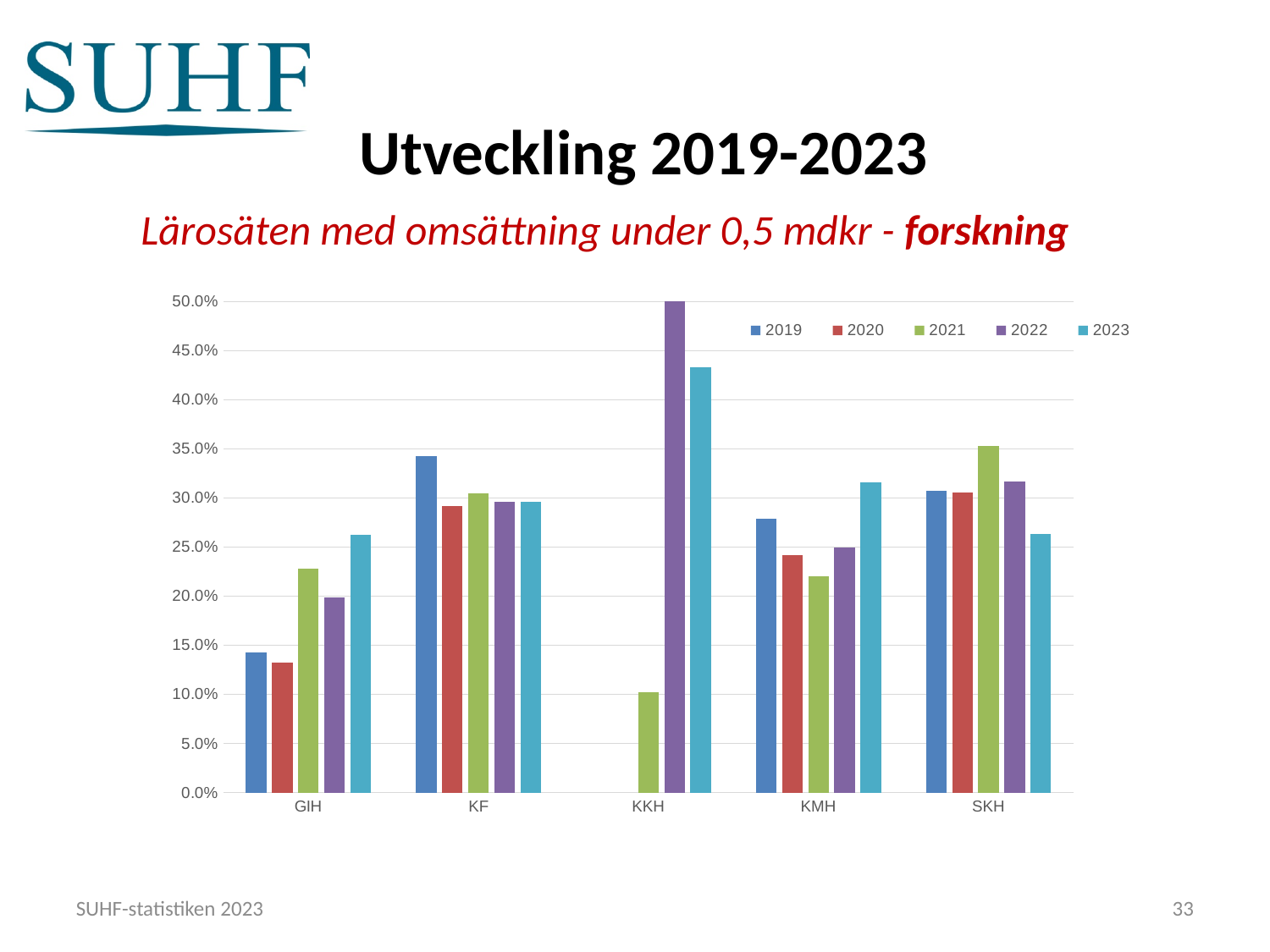
Is the 2019 value for KF greater or less than 30.0%? greater How many series does the legend list? 5 Which category has the highest value for 2023? KKH Which is larger, the 2019 value for KF or the 2019 value for KMH? KF Is the 2021 value for KKH greater or less than 15.0%? less Is the 2023 value for GIH greater or less than 25.0%? greater Which category has the lowest value for 2019? GIH What are the entries listed in the legend? 2019, 2020, 2021, 2022, 2023 Which category has the highest value for 2022? KKH What kind of chart is shown on the slide? bar chart How many categories are shown on the x axis? 5 For SKH, which is larger, the 2021 value or the 2023 value? 2021